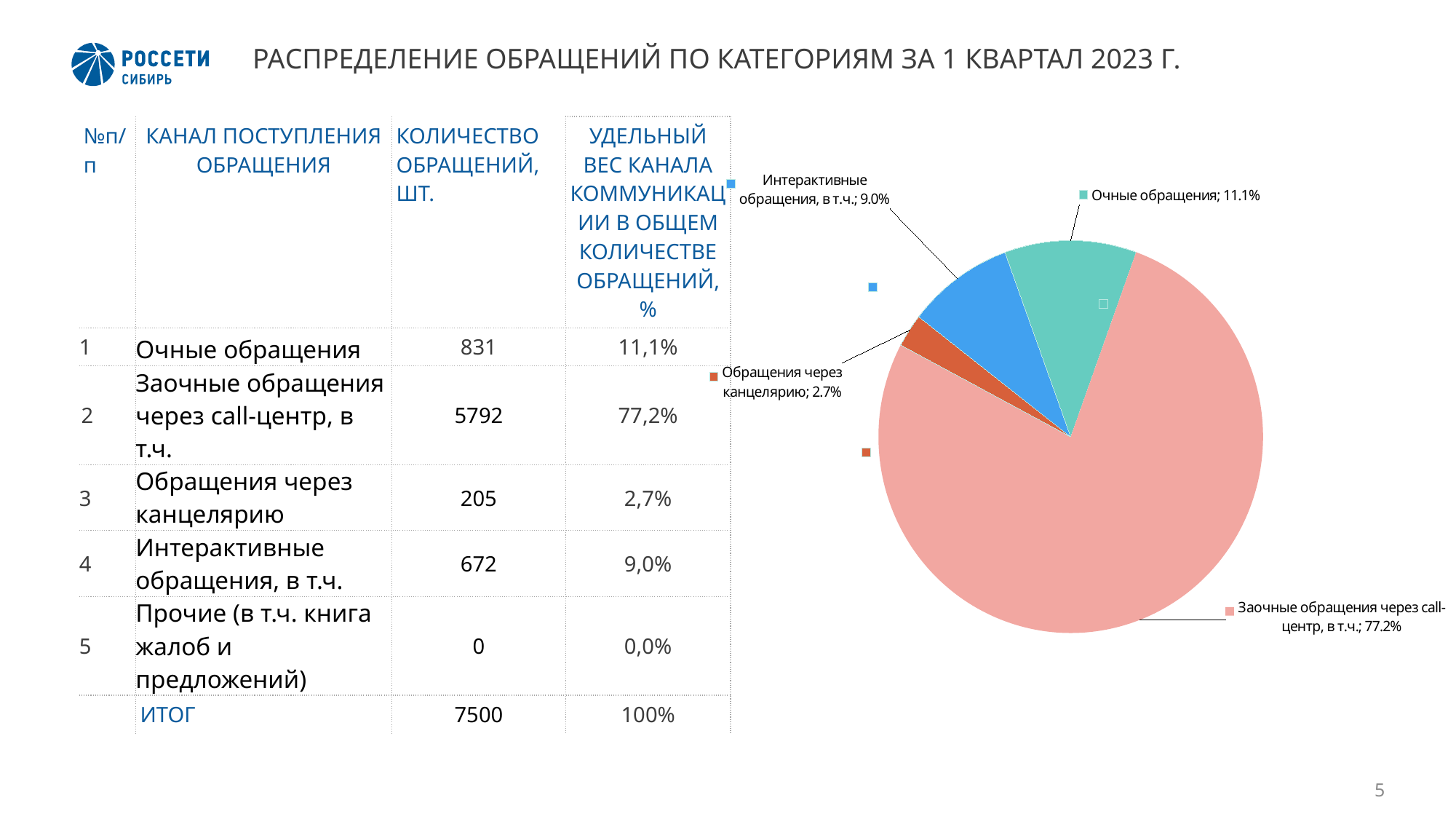
What kind of chart is shown on the slide? Pie chart In the pie chart, what share is labelled for "Обращения через канцелярию"? 2.7% Which slice of the pie chart is the smallest? Обращения через канцелярию In the pie chart, what is the difference in percentage points between "Заочные обращения через call-центр, в т.ч." and "Очные обращения"? 66.1 In the pie chart, what share is labelled for "Очные обращения"? 11.1% In the pie chart, what is the difference in percentage points between "Очные обращения" and "Интерактивные обращения, в т.ч."? 2.1 What colour is the largest slice of the pie chart? Pink (light red) Which slice of the pie chart is the largest? Заочные обращения через call-центр, в т.ч. In the pie chart, what share is labelled for "Заочные обращения через call-центр, в т.ч."? 77.2% In the pie chart, what share is labelled for "Интерактивные обращения, в т.ч."? 9.0% In the pie chart, which is larger: "Очные обращения" or "Интерактивные обращения, в т.ч."? Очные обращения How many labelled slices does the pie chart have? 4